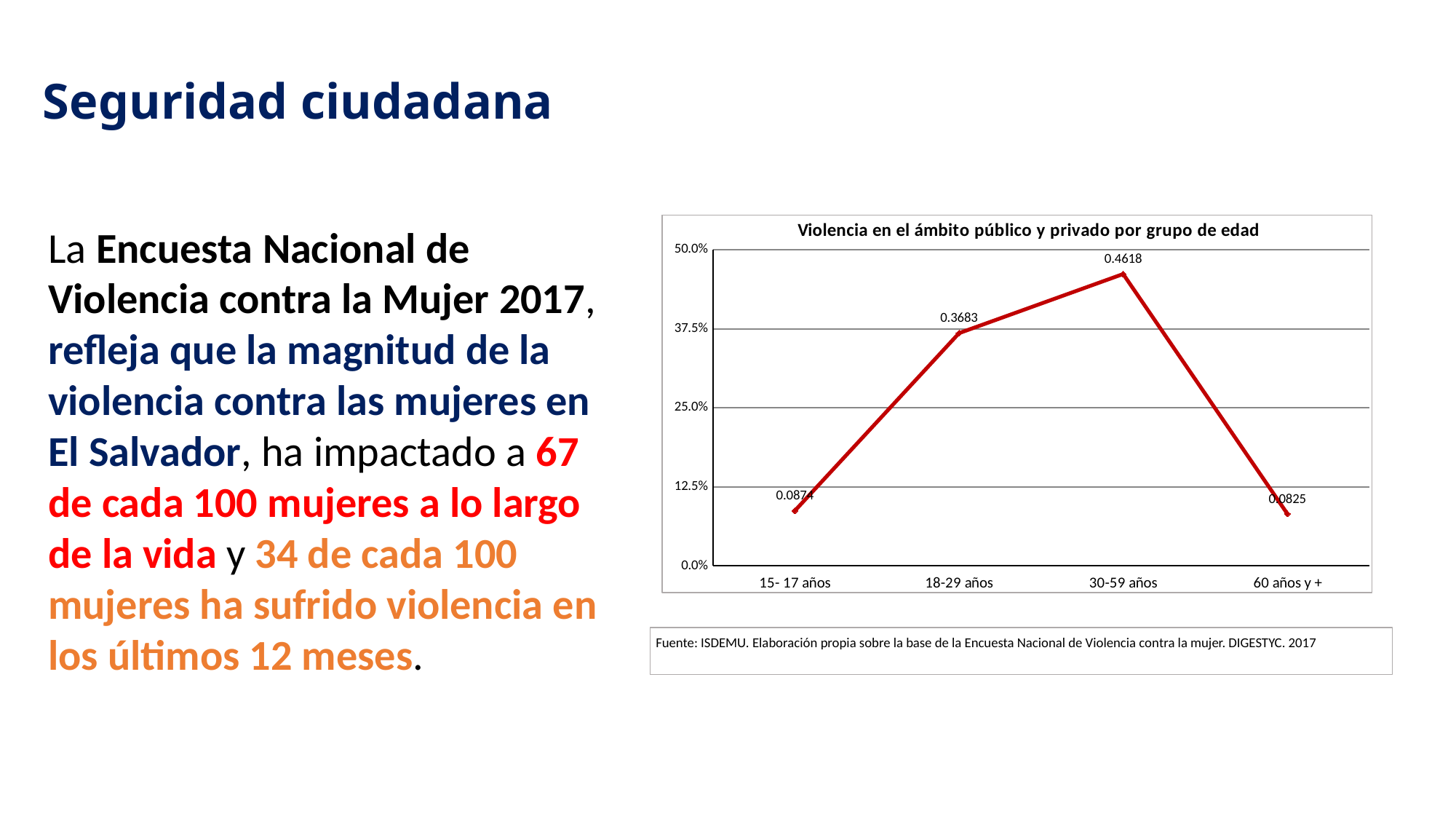
Is the value for 18-29 años greater or less than 25.0%? greater What is the value for 18-29 años? 0.3683 What is the value for 60 años y +? 0.0825 What kind of chart is shown on the slide? line chart How many age groups are plotted on the chart? 4 Which is larger, the value for 18-29 años or the value for 60 años y +? 18-29 años Which age group has the highest value? 30-59 años What is the title of the chart? Violencia en el ámbito público y privado por grupo de edad What is the difference between the values for 30-59 años and 18-29 años? 0.0935 Which age group has the lowest value? 60 años y + What is the value for 30-59 años? 0.4618 What is the value for 15- 17 años? 0.0874